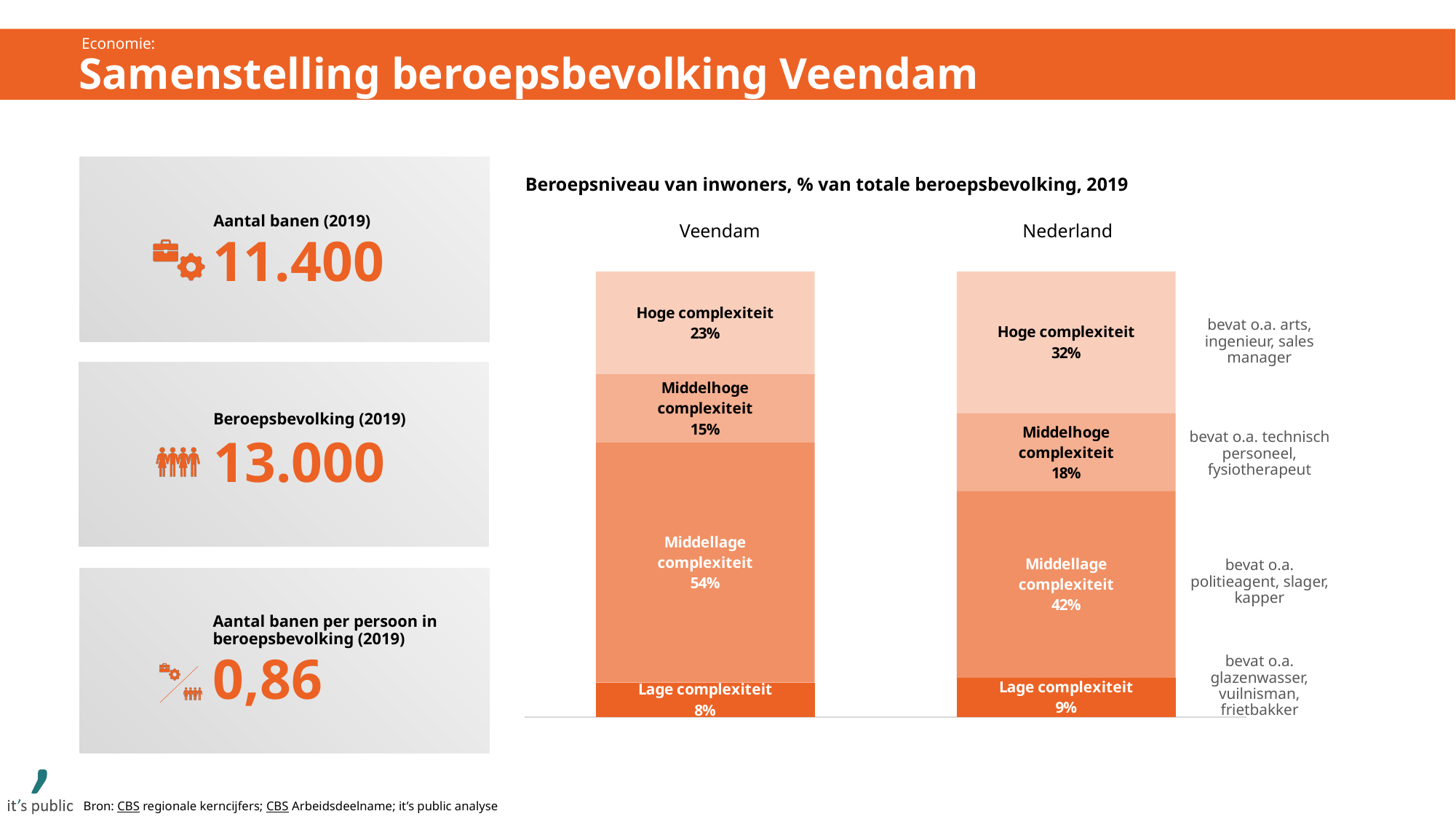
What is the difference in percentage points between Hoge complexiteit for Nederland and for Veendam? 9 What is the total of the four segments in the Veendam bar? 100% What is the value for Lage complexiteit in the Veendam bar? 8% Which segment is the smallest in the Nederland bar? Lage complexiteit How many stacked bars does the chart show? 2 What kind of chart is shown on the slide? Stacked bar chart Which has the larger share of Middellage complexiteit, Veendam or Nederland? Veendam What is the value for Middelhoge complexiteit in the Nederland bar? 18% Which segment is the largest in the Veendam bar? Middellage complexiteit What is the value for Middellage complexiteit in the Veendam bar? 54% How many complexity levels (segments) are shown in each bar? 4 What is the value for Hoge complexiteit in the Nederland bar? 32%